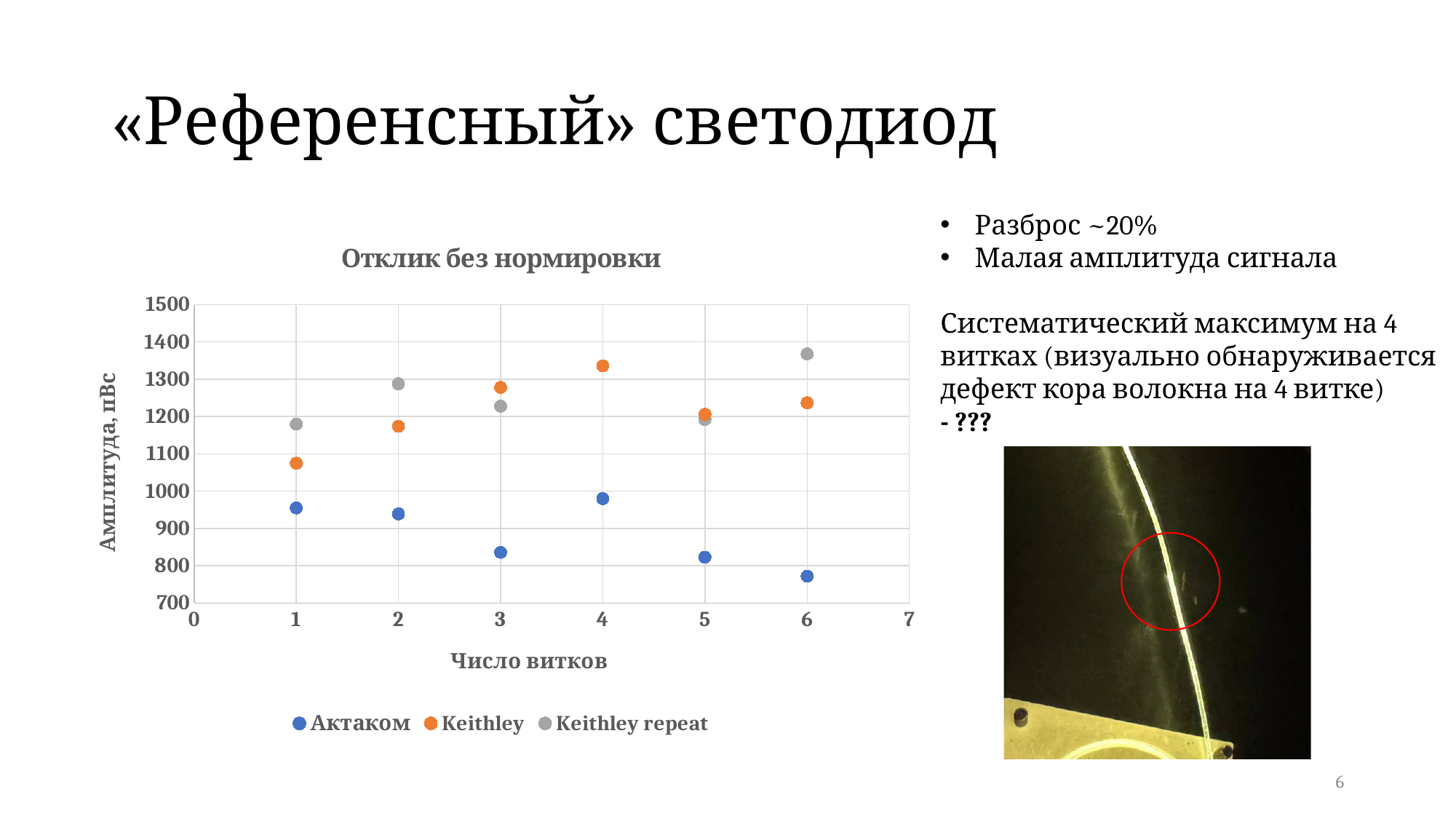
Is the Актаком value at 1 turn greater or less than 900? greater What kind of chart is shown on the slide? scatter chart At 1 turn, which series has the larger value: Keithley or Актаком? Keithley Is the Keithley repeat value at 6 turns greater or less than 1300? greater At which number of turns does the Актаком series have its lowest value? 6 At which number of turns does the Keithley series reach its highest value? 4 How many series does the legend of the chart list? 3 Do the Актаком values rise or fall from 4 turns to 6 turns? fall Is the Актаком value at 6 turns (Число витков = 6) greater or less than 800? less What is the title of the chart? Отклик без нормировки What is the label of the vertical axis of the chart? Амплитуда, пВс